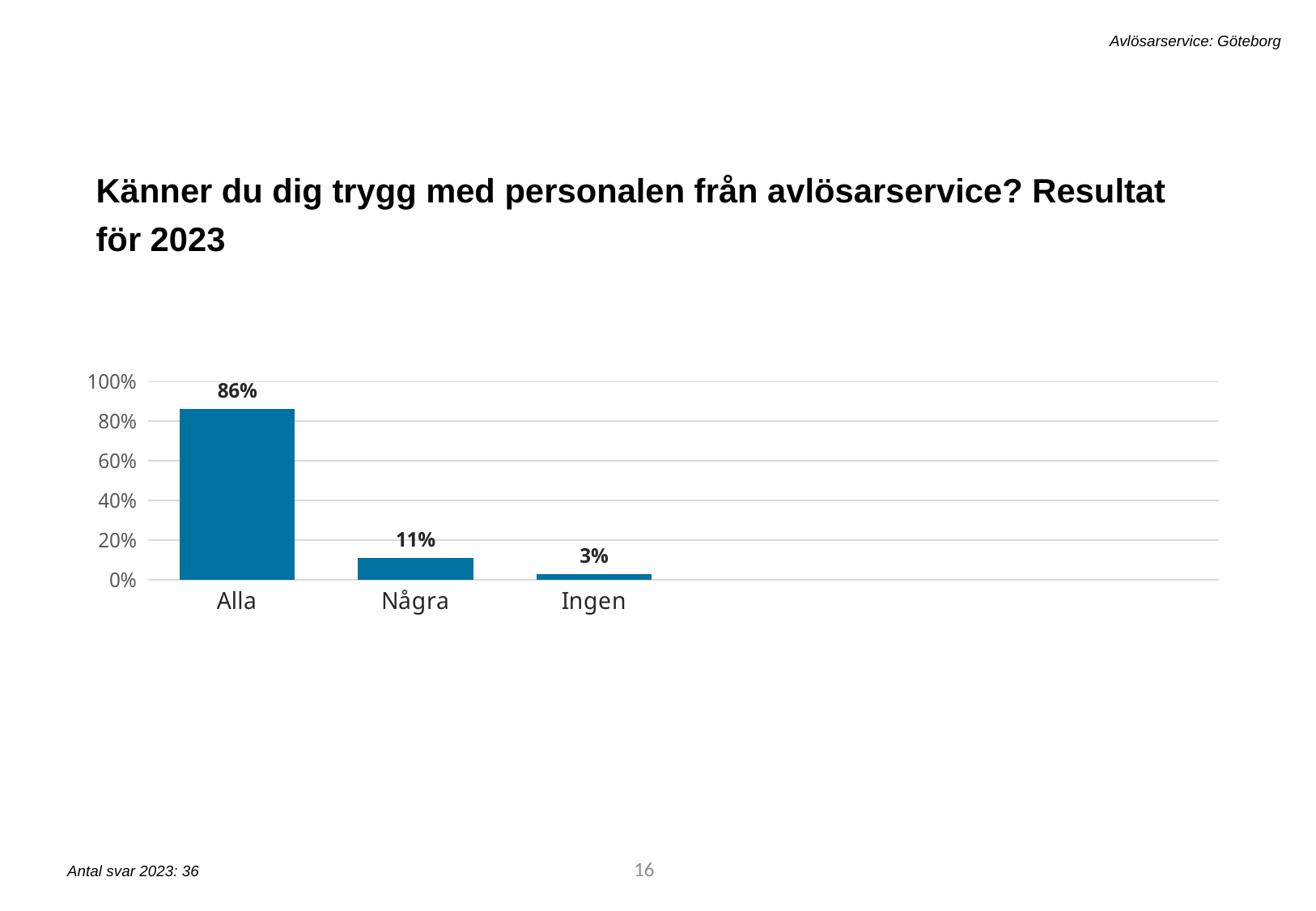
What kind of chart is shown on the slide? bar chart Which category has the lowest value? Ingen What is the difference between the values for Några and Ingen? 8% Which is larger, the value for Några or the value for Ingen? Några Is the value for Alla greater or less than 80%? greater How many categories are shown on the x axis? 3 Which category has the highest value? Alla What is the value for Alla? 86% What is the difference between the values for Alla and Några? 75% What is the value for Ingen? 3% What is the value for Några? 11% Do the values rise or fall from left to right along the x axis? fall